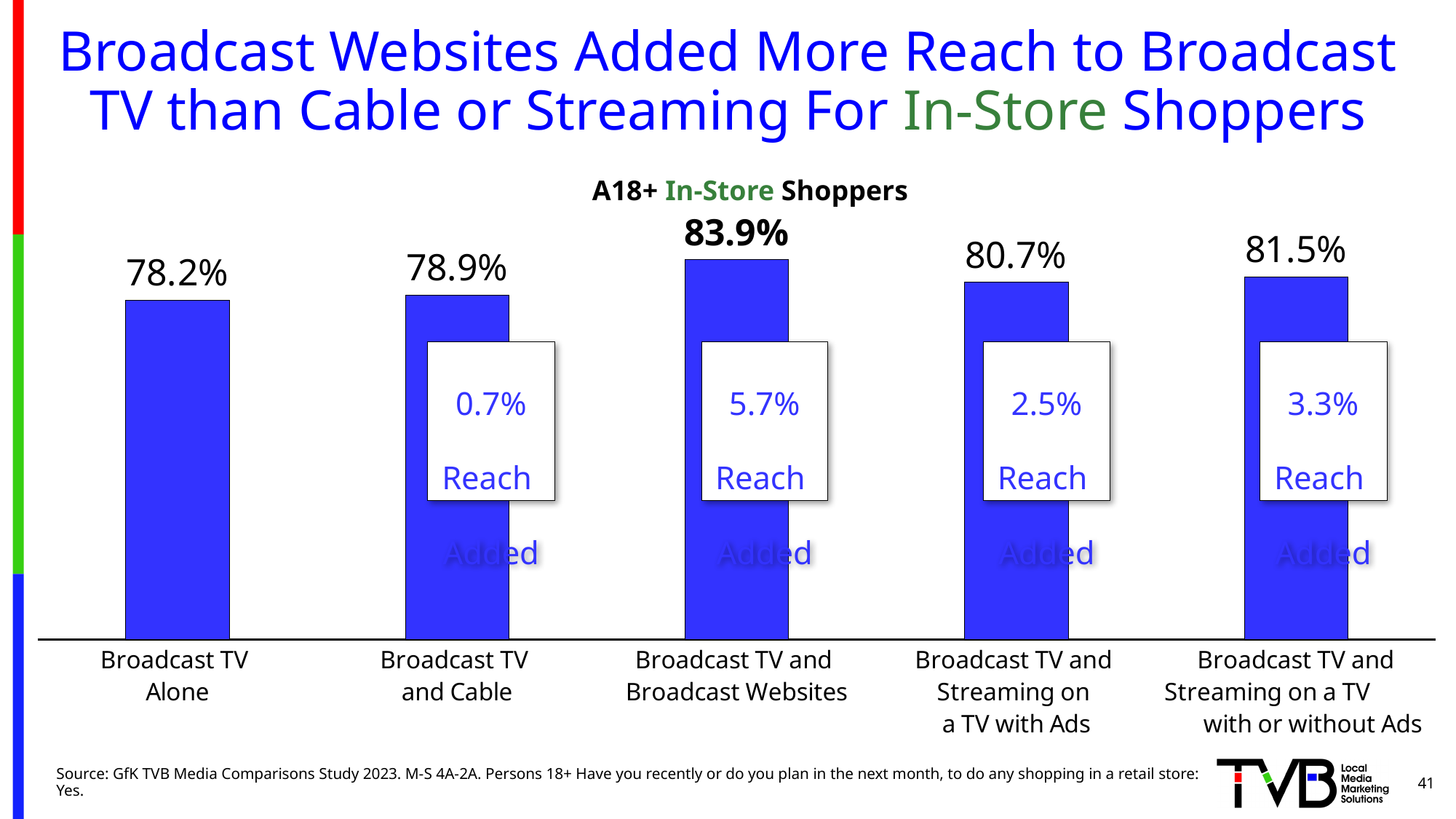
Which is larger: Broadcast TV and Cable or Broadcast TV and Streaming on a TV with Ads? Broadcast TV and Streaming on a TV with Ads What is the value for Broadcast TV Alone? 78.2% What is the value for Broadcast TV and Streaming on a TV with or without Ads? 81.5% What is the value for Broadcast TV and Streaming on a TV with Ads? 80.7% What is the difference between Broadcast TV and Broadcast Websites and Broadcast TV Alone? 5.7% What kind of chart is shown on the slide? Bar chart What is the value for Broadcast TV and Broadcast Websites? 83.9% Which category has the highest value? Broadcast TV and Broadcast Websites What is the title of the chart? A18+ In-Store Shoppers Which category has the lowest value? Broadcast TV Alone What is the reach added by Broadcast TV and Cable over Broadcast TV Alone, as labelled on the chart? 0.7% How many categories are shown in the chart? 5